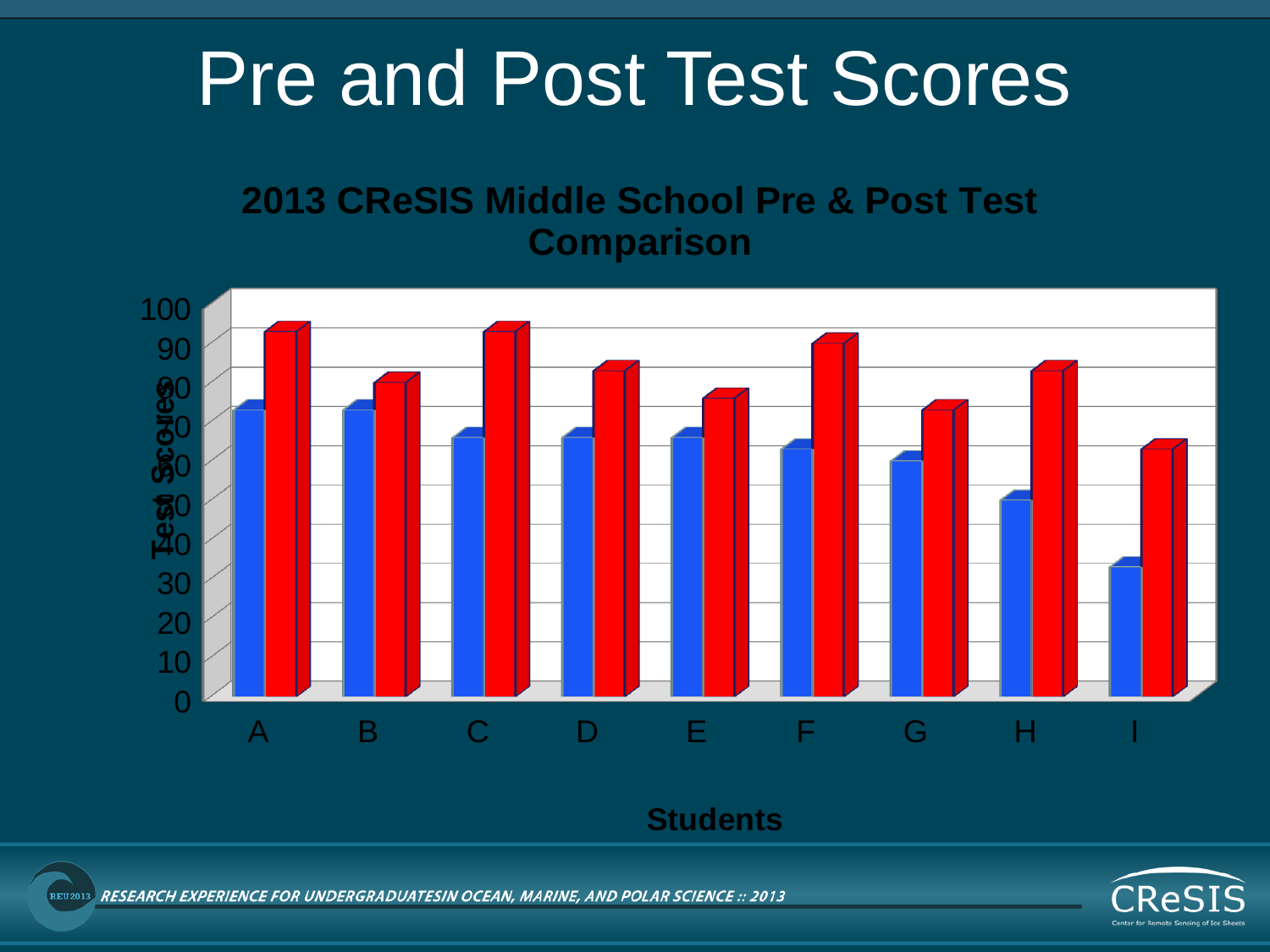
Is the red bar for student I greater or less than 50? greater Is the blue bar for student I greater or less than 40? less Do the blue bars generally rise or fall from student A to student I? fall How many students (categories) are shown on the x axis? 9 Which student has the lowest red bar? I What kind of chart is shown on the slide? bar chart Is the blue bar for student H greater or less than 60? less What is the label of the vertical axis? Test Scores For student E, which bar is taller, the blue bar or the red bar? the red bar What is the title of the chart? 2013 CReSIS Middle School Pre & Post Test Comparison Which student has the lowest blue bar? I